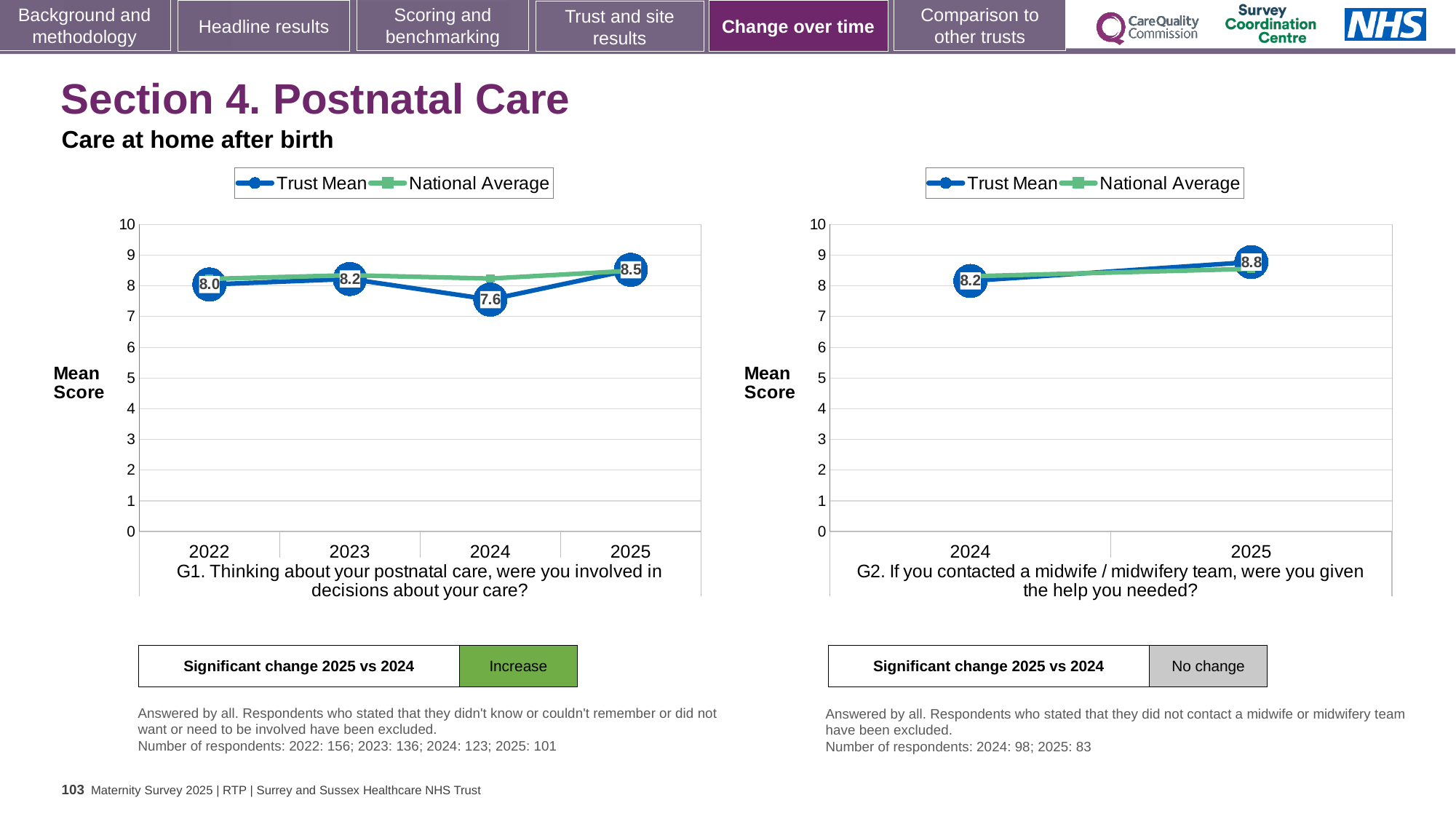
On the G2 chart (right), what is the Trust Mean for 2024? 8.2 On the G2 chart (right), how many series does the legend list? 2 On the G1 chart (left), how many years are plotted on the x axis? 4 On the G1 chart (left), what is the difference between the Trust Mean for 2025 and 2024? 0.9 On the G1 chart (left), what is the Trust Mean for 2025? 8.5 On the G2 chart (right), does the Trust Mean rise or fall from 2024 to 2025? rise On the G1 chart (left), what is the Trust Mean for 2022? 8.0 On the G1 chart (left), what is the Trust Mean for 2024? 7.6 What kind of chart is the G1 chart (left)? line chart On the G1 chart (left), which year has the highest Trust Mean? 2025 On the G1 chart (left), which year has the lowest Trust Mean? 2024 On the G2 chart (right), what is the Trust Mean for 2025? 8.8